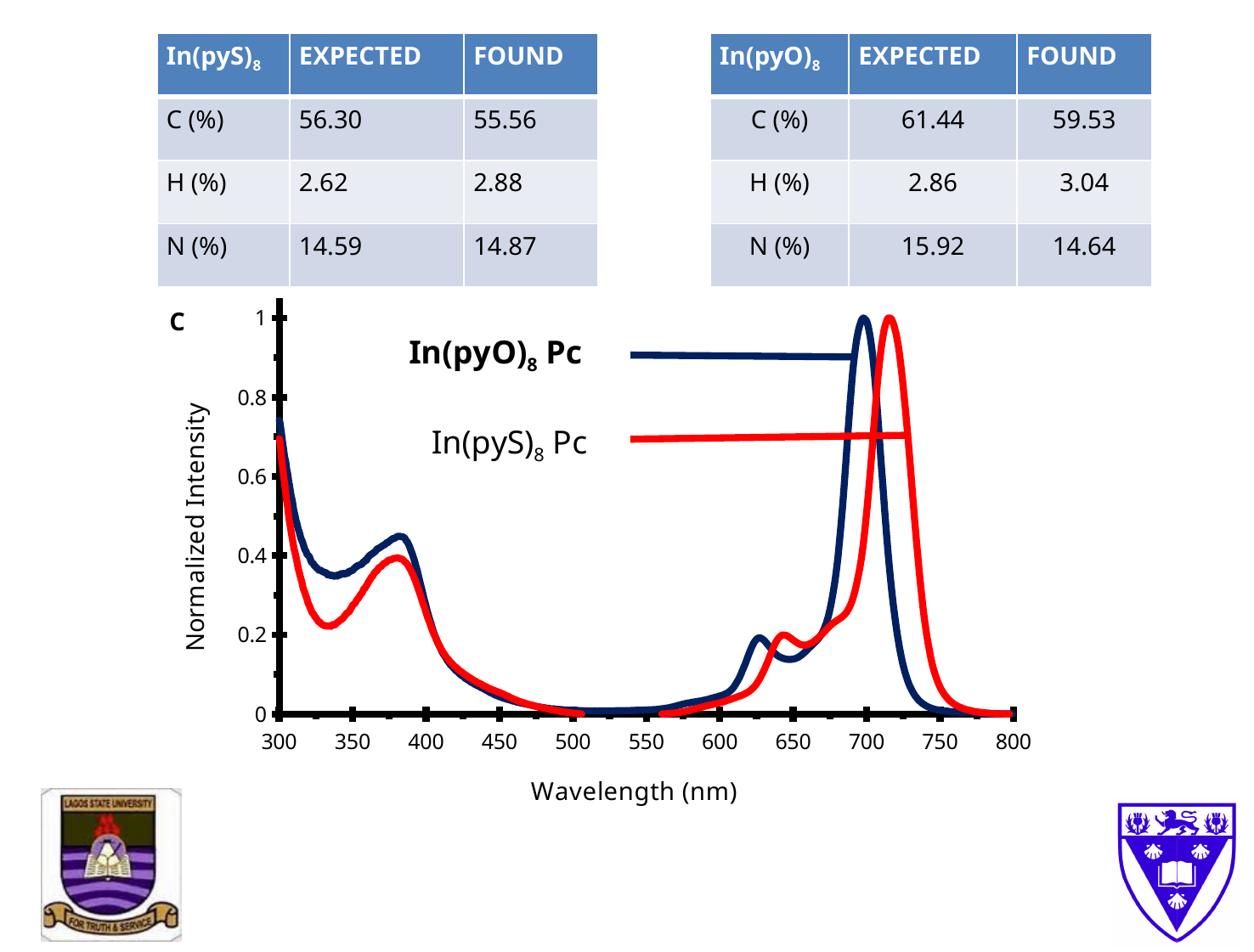
At 340 nm, which series has the higher normalized intensity, In(pyO)8 Pc or In(pyS)8 Pc? In(pyO)8 Pc Is the value for In(pyO)8 Pc at 750 nm greater or less than 0.2? less Is the value for In(pyS)8 Pc at 500 nm greater or less than 0.2? less Between 400 nm and 500 nm, do the values for In(pyO)8 Pc rise or fall? fall Is the value for In(pyO)8 Pc at 700 nm greater or less than 0.8? greater At 720 nm, which series has the higher normalized intensity, In(pyO)8 Pc or In(pyS)8 Pc? In(pyS)8 Pc What is the label of the x axis of the chart? Wavelength (nm) Which series is drawn in red? In(pyS)8 Pc What is the label of the y axis of the chart? Normalized Intensity What kind of chart is shown on the slide? line chart How many series are plotted in the chart? 2